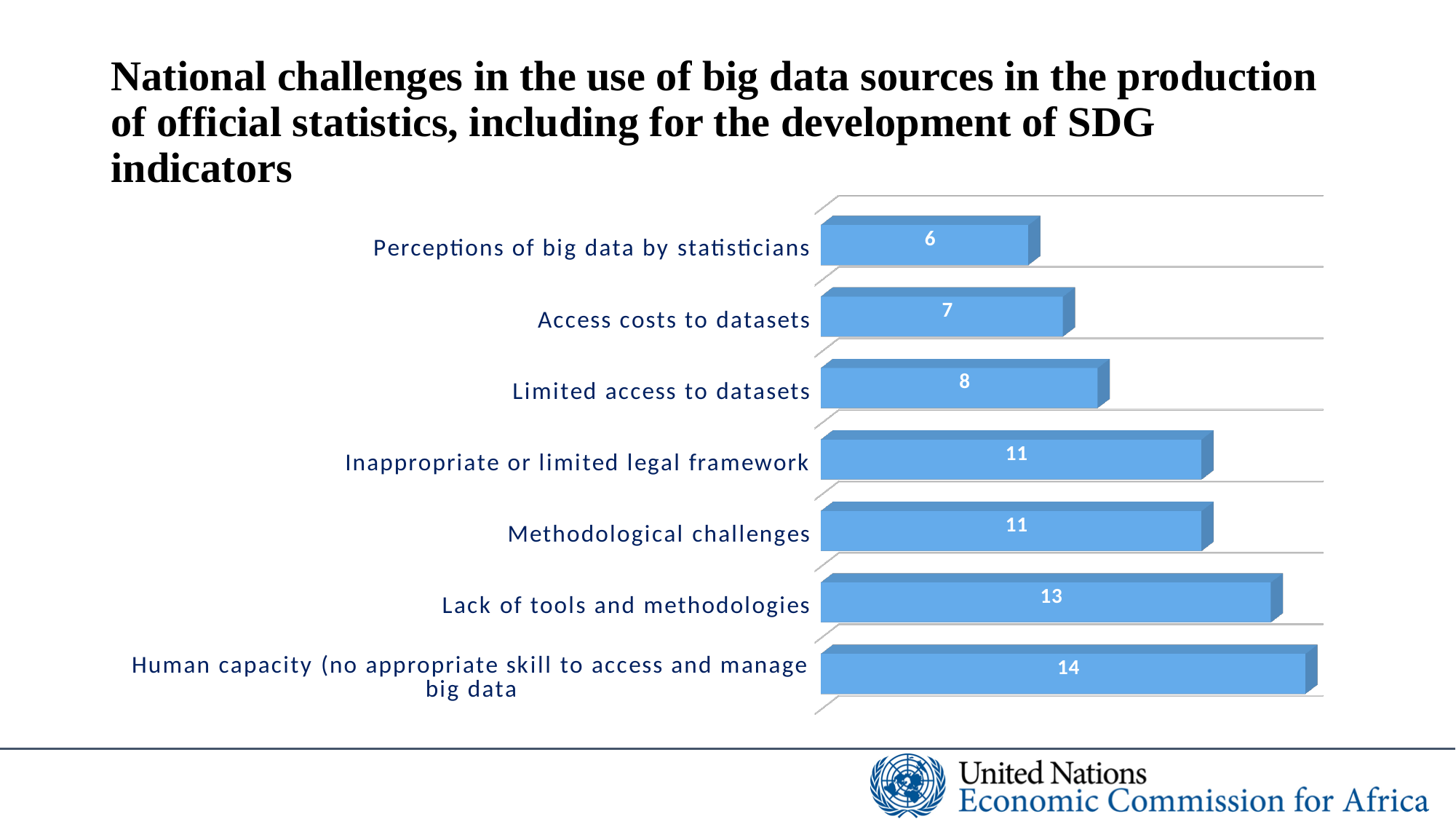
Which is larger, the value for Limited access to datasets or the value for Access costs to datasets? Limited access to datasets What is the difference between the values for Lack of tools and methodologies and Limited access to datasets? 5 What is the value for Human capacity (no appropriate skill to access and manage big data)? 14 What is the value for Access costs to datasets? 7 What kind of chart is shown on the slide? Bar chart What is the value for Lack of tools and methodologies? 13 Which category has the highest value? Human capacity (no appropriate skill to access and manage big data How many categories are shown in the chart? 7 What is the difference between the values for Human capacity and Perceptions of big data by statisticians? 8 What is the value for Perceptions of big data by statisticians? 6 Which category has the lowest value? Perceptions of big data by statisticians Which two categories share the same value of 11? Inappropriate or limited legal framework and Methodological challenges